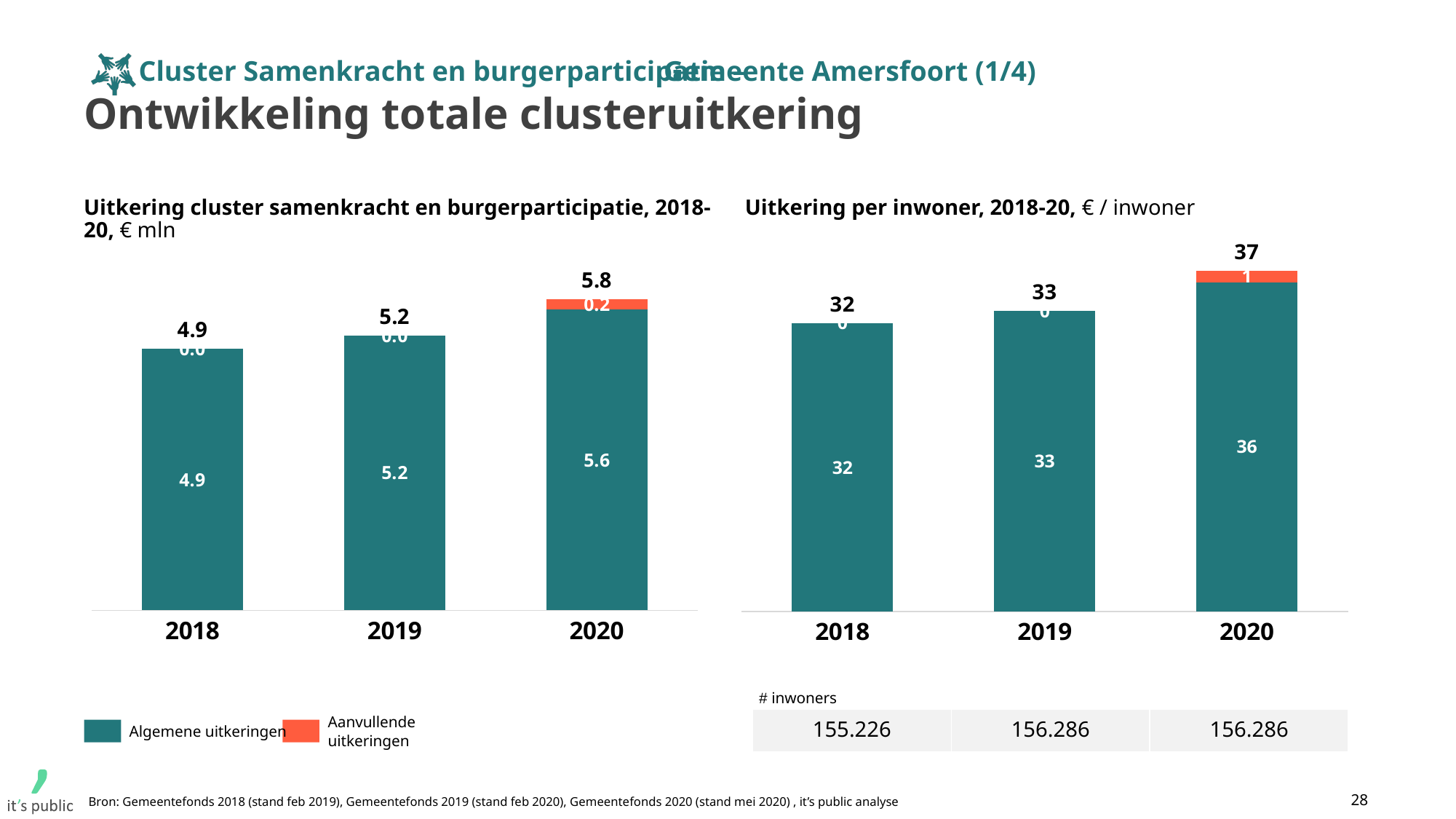
How many series does the legend list for the charts on this slide? 2 In the left chart (Uitkering cluster samenkracht en burgerparticipatie), what is the value of Algemene uitkeringen in 2019? 5.2 What type of chart is the left chart (Uitkering cluster samenkracht en burgerparticipatie)? stacked bar chart In the right chart (Uitkering per inwoner), which year has the highest total value? 2020 In the left chart (Uitkering cluster samenkracht en burgerparticipatie), what is the value of Aanvullende uitkeringen in 2020? 0.2 In the right chart (Uitkering per inwoner), what is the total value for 2020? 37 In the right chart (Uitkering per inwoner), what is the difference between the total for 2019 and the total for 2018? 1 In the right chart (Uitkering per inwoner), what is the value of Algemene uitkeringen in 2020? 36 In the left chart (Uitkering cluster samenkracht en burgerparticipatie), what is the difference between the total for 2020 and the total for 2018? 0.9 In the left chart (Uitkering cluster samenkracht en burgerparticipatie), what is the total uitkering for 2020? 5.8 In the left chart (Uitkering cluster samenkracht en burgerparticipatie), which year has the lowest total uitkering? 2018 In the left chart (Uitkering cluster samenkracht en burgerparticipatie), do the total values rise or fall from 2018 to 2020? rise